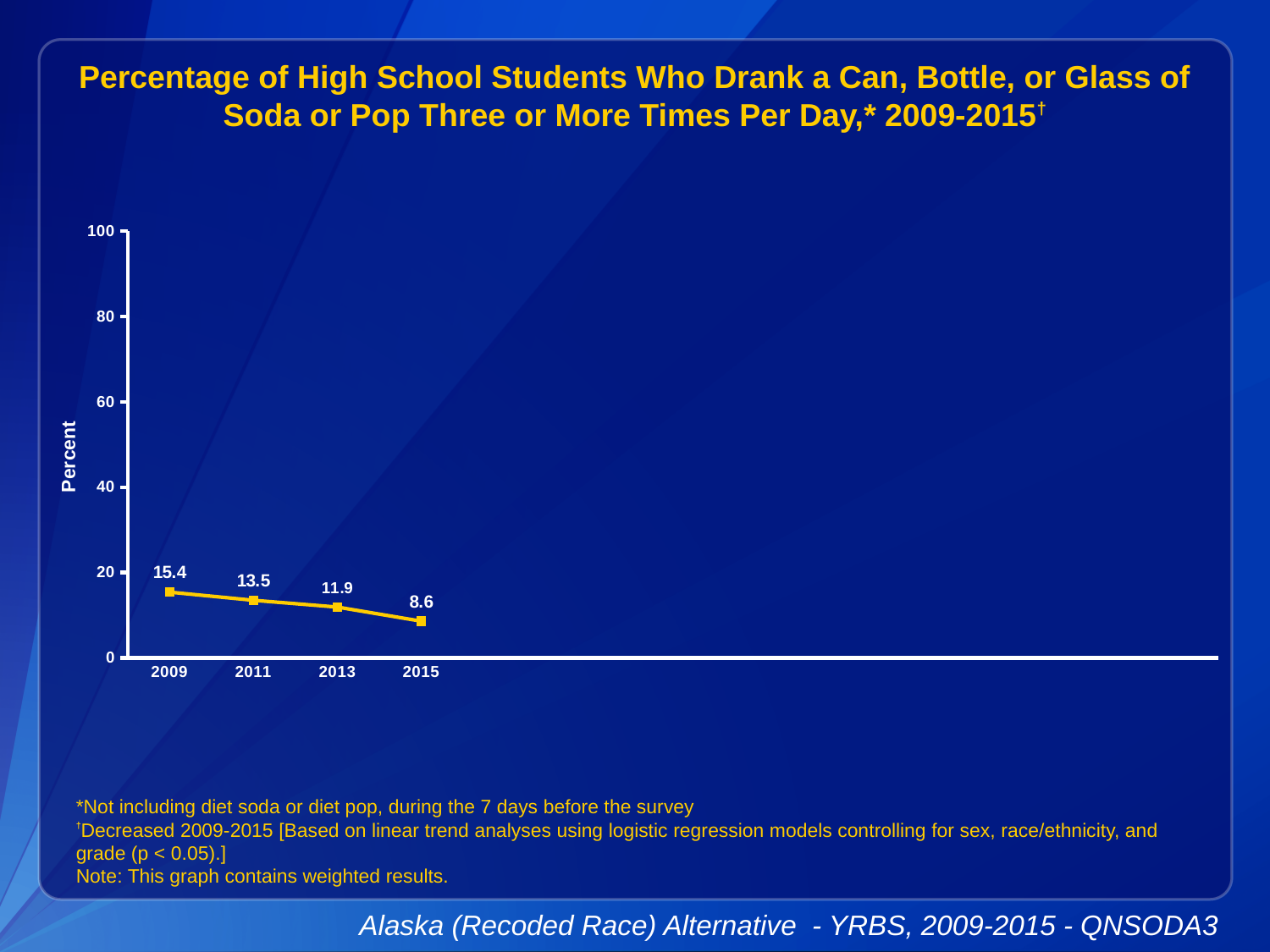
What is the value plotted for 2013? 11.9 What is the value plotted for 2015? 8.6 Which year has the lowest value on the chart? 2015 What percentage of high school students drank soda or pop three or more times per day in 2009? 15.4 What is the label on the vertical axis? Percent Which year has the highest value on the chart? 2009 Which is larger, the value for 2011 or the value for 2013? 2011 What kind of chart is shown on the slide? line chart What is the difference between the 2009 value and the 2015 value? 6.8 Do the values rise or fall from 2009 to 2015? fall Is the value for 2009 greater or less than 20? less How many years are plotted on the chart? 4